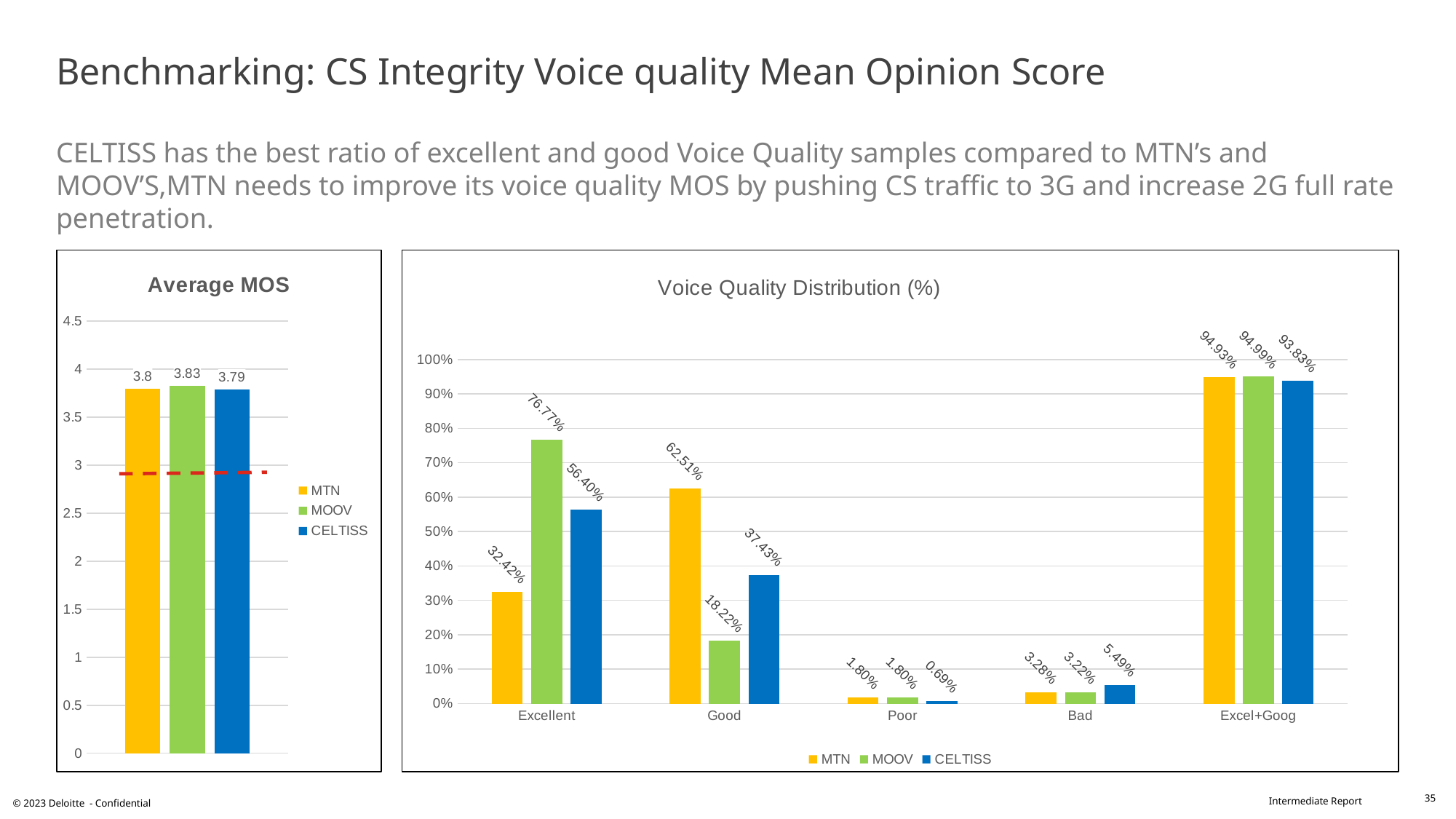
In the Average MOS chart, which operator has the lowest average MOS? CELTISS In the Voice Quality Distribution (%) chart, what is the value for MOOV in the Excellent category? 76.77% In the Voice Quality Distribution (%) chart, what is the value for CELTISS in the Good category? 37.43% In the Voice Quality Distribution (%) chart, what is the value for MTN in the Excel+Goog category? 94.93% In the Average MOS chart, what is the value for MOOV? 3.83 What kind of chart is the Voice Quality Distribution (%) chart? Bar chart In the Voice Quality Distribution (%) chart, which operator has the highest value in the Excellent category? MOOV In the Voice Quality Distribution (%) chart, which operator has the lowest value in the Poor category? CELTISS In the Average MOS chart, how many series does the legend list? 3 In the Voice Quality Distribution (%) chart, how many categories are shown on the x axis? 5 In the Voice Quality Distribution (%) chart, which is larger in the Bad category: MTN or CELTISS? CELTISS In the Voice Quality Distribution (%) chart, what is the difference between MTN and MOOV in the Good category? 44.29%